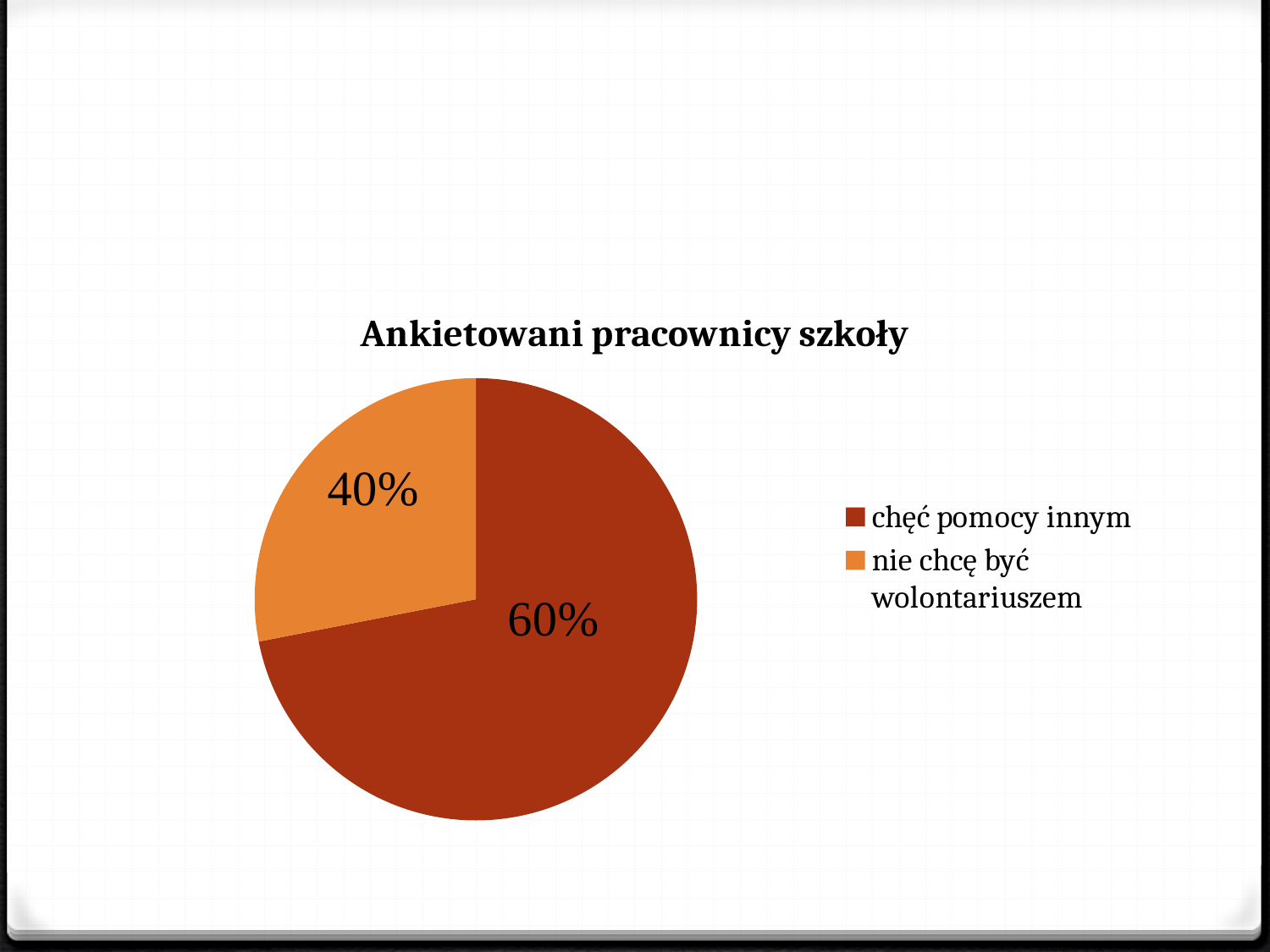
What colour is the "nie chcę być wolontariuszem" slice? orange What kind of chart is shown on the slide? pie chart What is the title of the chart? Ankietowani pracownicy szkoły How many slices does the pie chart have? 2 What is the difference in percentage points between the "chęć pomocy innym" slice and the "nie chcę być wolontariuszem" slice? 20 percentage points Which is larger: the "chęć pomocy innym" slice or the "nie chcę być wolontariuszem" slice? chęć pomocy innym What share of the pie is labelled "nie chcę być wolontariuszem"? 40% Which slice of the pie is the smallest? nie chcę być wolontariuszem Is the share for "chęć pomocy innym" greater or less than 50%? greater How many entries does the legend list? 2 Which slice of the pie is the largest? chęć pomocy innym What share of the pie is labelled "chęć pomocy innym"? 60%